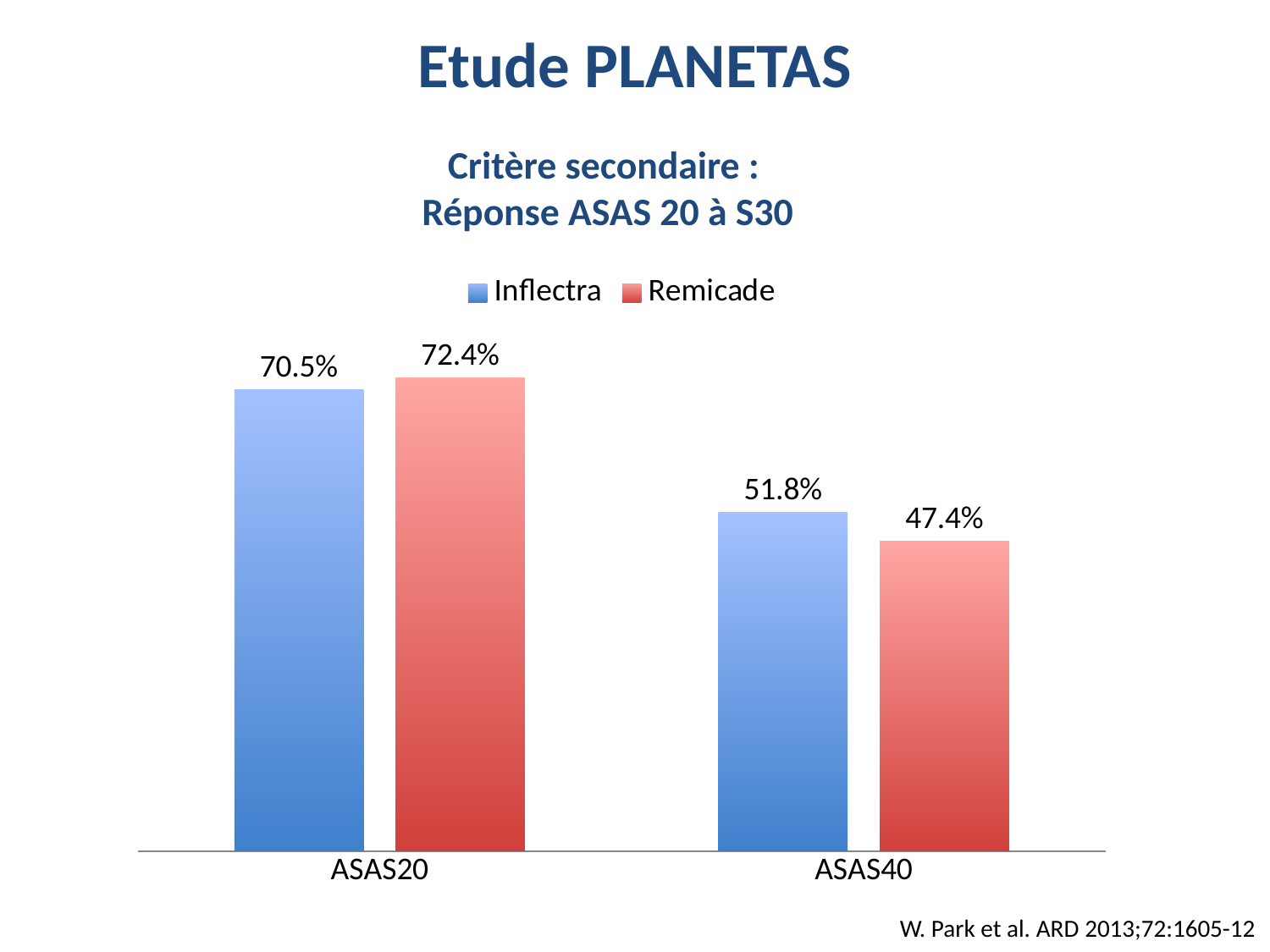
What is the value for Remicade in the ASAS40 category? 47.4% What is the value for Inflectra in the ASAS40 category? 51.8% What is the value for Inflectra in the ASAS20 category? 70.5% What kind of chart is shown on the slide? bar chart How many categories are shown on the x axis? 2 Which series has the highest value in the ASAS20 category? Remicade Which series has the lowest value in the ASAS40 category? Remicade What is the difference between the Inflectra and Remicade values for ASAS40? 4.4% Is the Inflectra value for ASAS20 larger or smaller than the Inflectra value for ASAS40? larger What is the difference between the Remicade and Inflectra values for ASAS20? 1.9% What is the value for Remicade in the ASAS20 category? 72.4% How many series does the legend list? 2